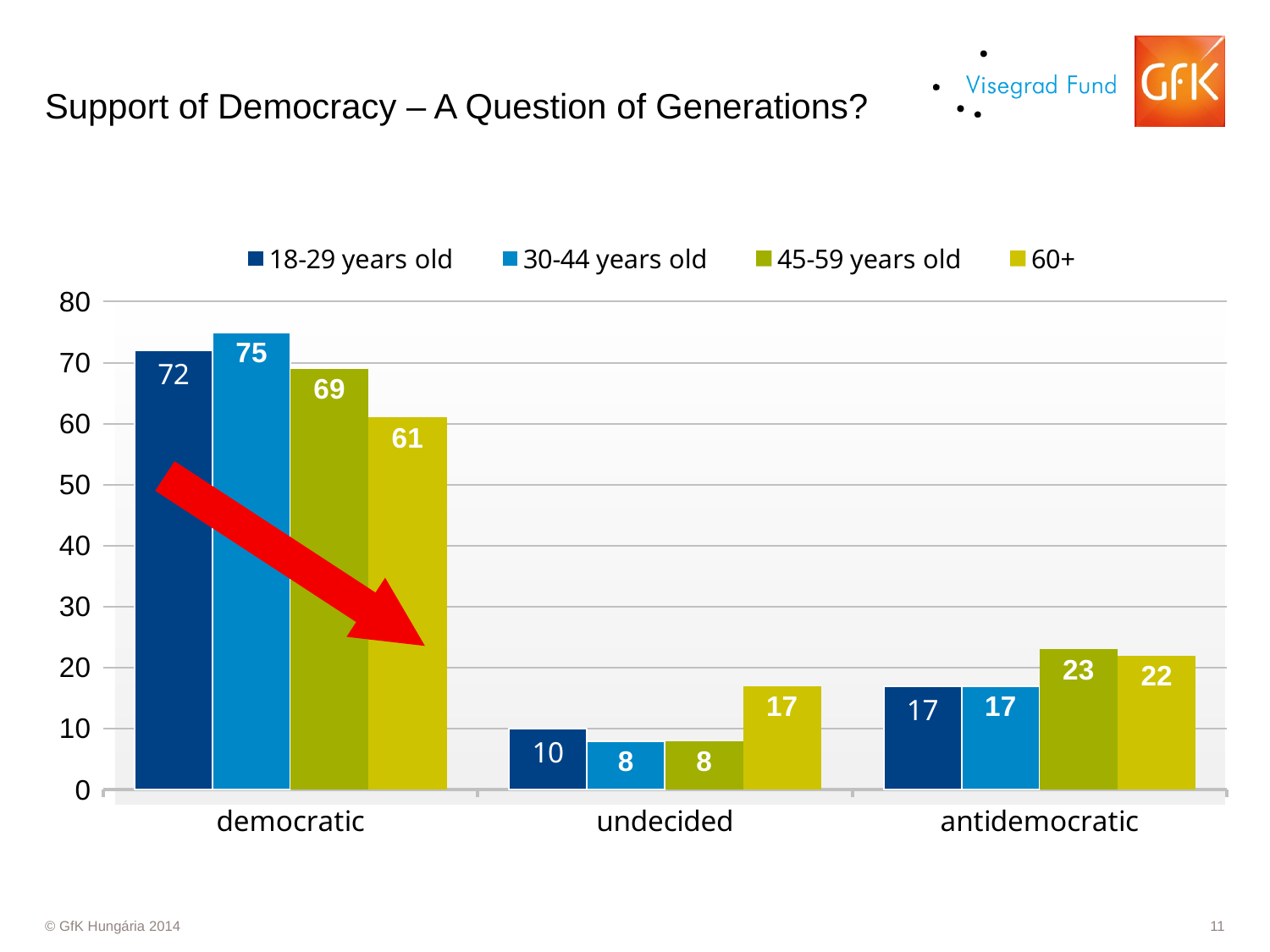
Which age group has the lowest value in the democratic category? 60+ What is the value for the 60+ series in the undecided category? 17 What is the difference between the 30-44 years old and 60+ values in the democratic category? 14 Do the values in the democratic category rise or fall as the age groups get older? They do not fall consistently: 72, 75, 69, 61 (rise from 18-29 to 30-44, then fall) What is the value for the 45-59 years old series in the antidemocratic category? 23 How many categories are shown on the x axis? 3 What is the title of the slide? Support of Democracy – A Question of Generations? How many series does the legend list? 4 Which age group has the highest value in the democratic category? 30-44 years old In the antidemocratic category, which is larger: the value for 45-59 years old or the value for 18-29 years old? 45-59 years old What is the value for the 30-44 years old series in the democratic category? 75 What kind of chart is shown on the slide? bar chart